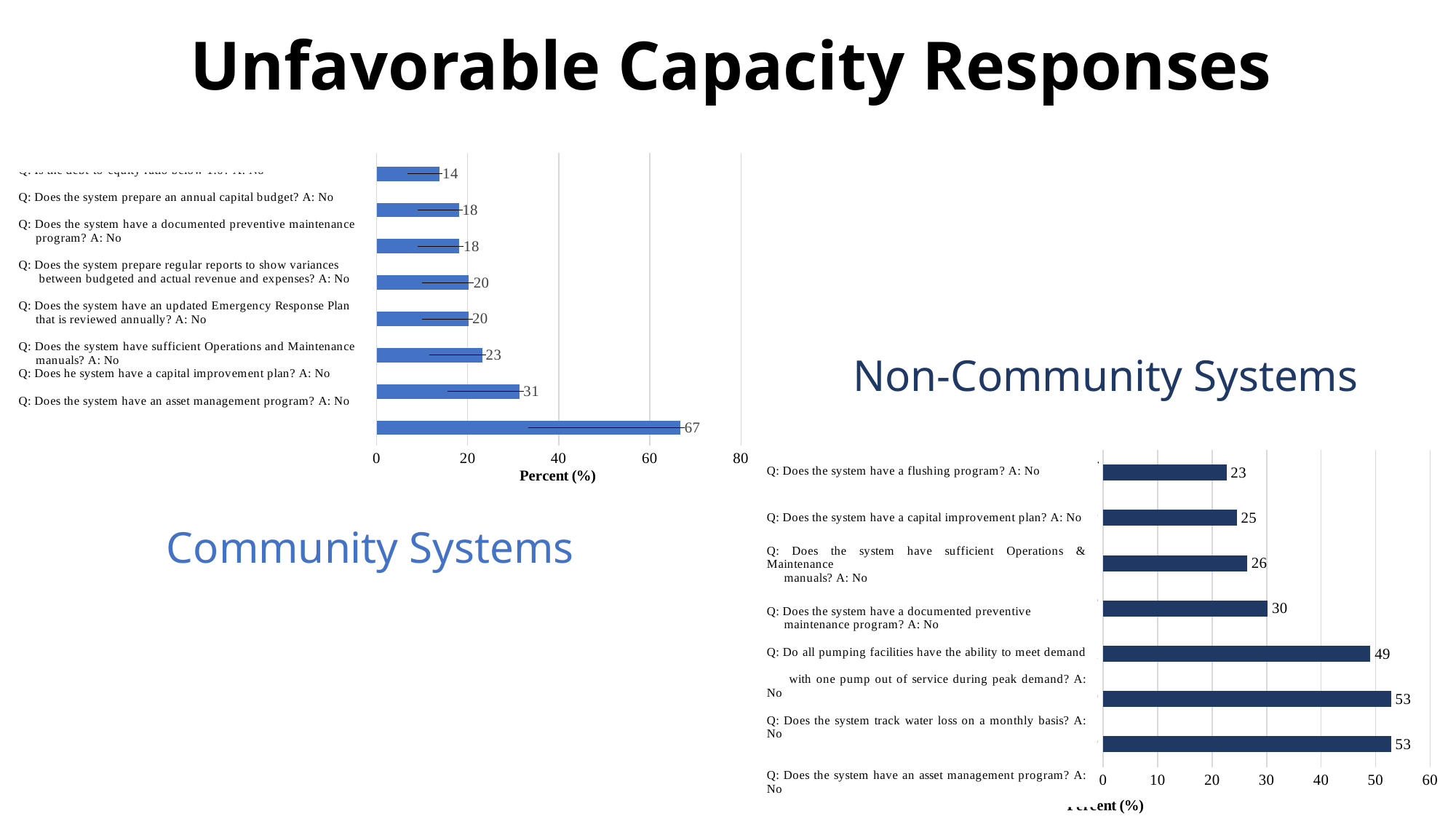
What is the x-axis label of the Community Systems chart? Percent (%) In the Non-Community Systems chart, what is the highest value shown? 53 In the Non-Community Systems chart, what is the value for 'Do all pumping facilities have the ability to meet demand with one pump out of service during peak demand? A: No'? 49 What is the lowest value shown in the Community Systems chart? 14 What is the highest value shown in the Community Systems chart? 67 In the Non-Community Systems chart, what is the value for 'Does the system have a flushing program? A: No'? 23 In the Non-Community Systems chart, which is larger: the value for the capital improvement plan question or the value for the preventive maintenance program question? preventive maintenance program In the Community Systems chart, what is the difference between the highest value (67) and the second highest value (31)? 36 How many bars are plotted in the Non-Community Systems chart? 7 How many bars are plotted in the Community Systems chart? 8 In the Non-Community Systems chart, what is the value for 'Does the system have a documented preventive maintenance program? A: No'? 30 What type of chart is the Community Systems chart? bar chart